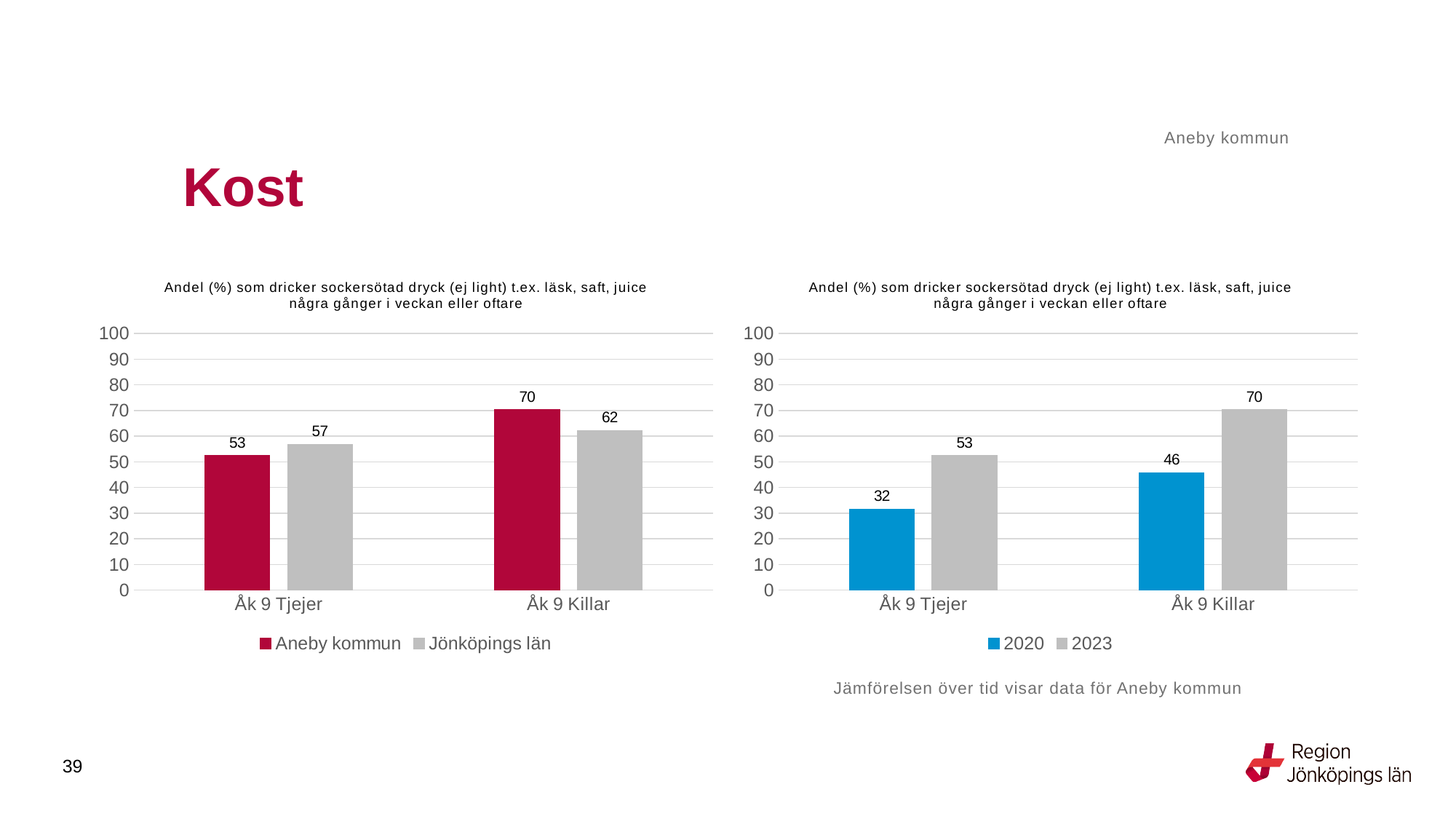
In the right chart, what is the difference between 2023 and 2020 for Åk 9 Tjejer? 21 What kind of chart is the left chart? Bar chart In the right chart, how many series does the legend list? 2 In the right chart, what are the two legend entries? 2020 and 2023 In the right chart, which bar is the lowest? 2020, Åk 9 Tjejer In the left chart, what is the value for Jönköpings län for Åk 9 Killar? 62 In the right chart, what is the value for 2023 for Åk 9 Killar? 70 In the left chart, what is the difference between Aneby kommun and Jönköpings län for Åk 9 Killar? 8 In the left chart, which bar is the highest? Aneby kommun, Åk 9 Killar In the left chart, what is the value for Aneby kommun for Åk 9 Tjejer? 53 In the right chart, what is the value for 2020 for Åk 9 Tjejer? 32 In the left chart, which is larger for Åk 9 Tjejer: Aneby kommun or Jönköpings län? Jönköpings län